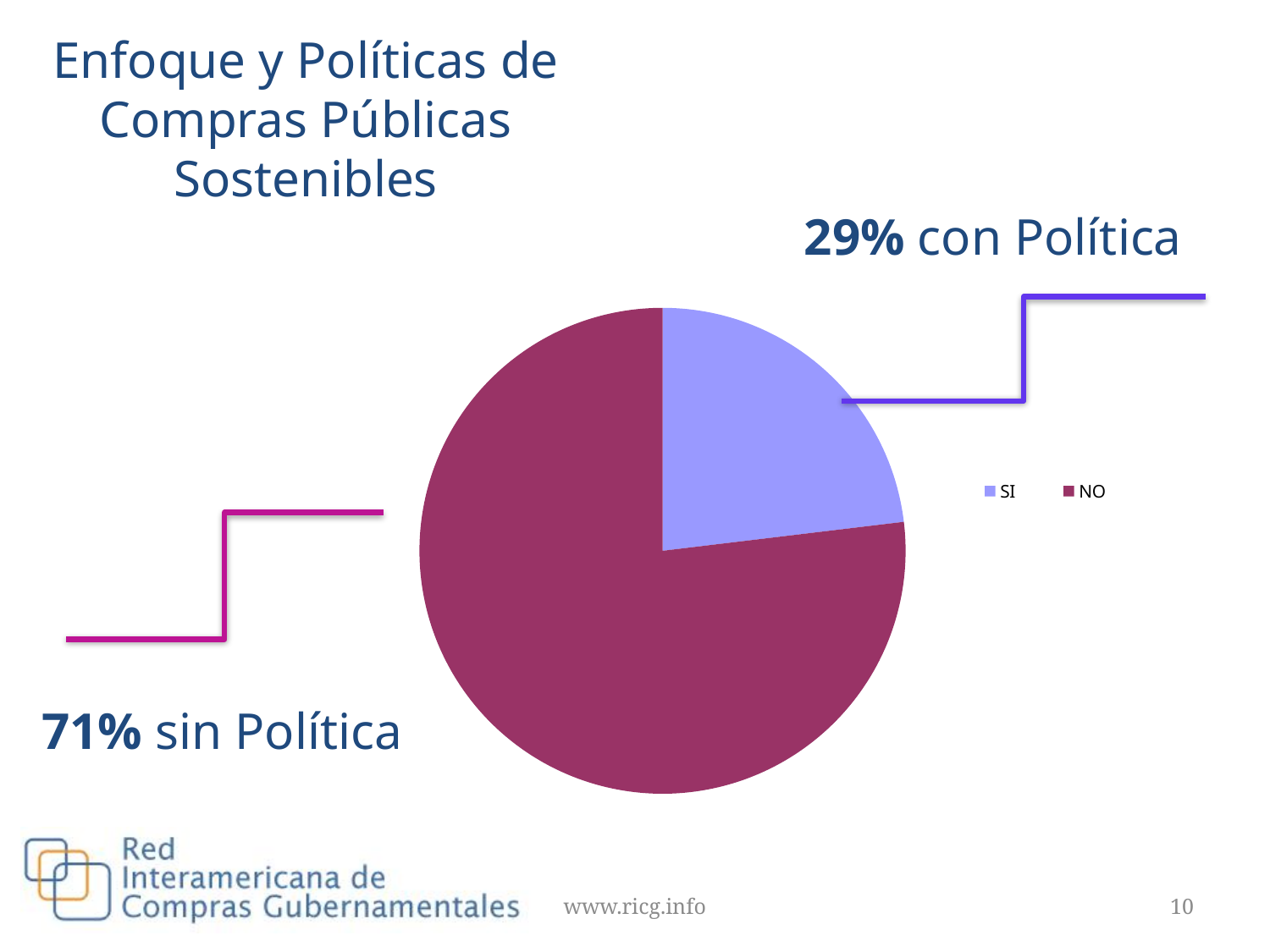
Is the share for NO greater or less than 50%? greater Which is larger, the SI slice or the NO slice? NO What are the two legend entries of the pie chart? SI and NO Which slice of the pie chart is the smallest? SI How many entries does the legend of the pie chart list? 2 What is the difference in percentage points between the NO share and the SI share? 42 What share of the pie corresponds to the SI slice (con Política)? 29% What kind of chart is shown on the slide? pie chart Which slice of the pie chart is the largest? NO What share of the pie corresponds to the NO slice (sin Política)? 71% How many slices does the pie chart have? 2 What is the title shown above the chart on the slide? Enfoque y Políticas de Compras Públicas Sostenibles